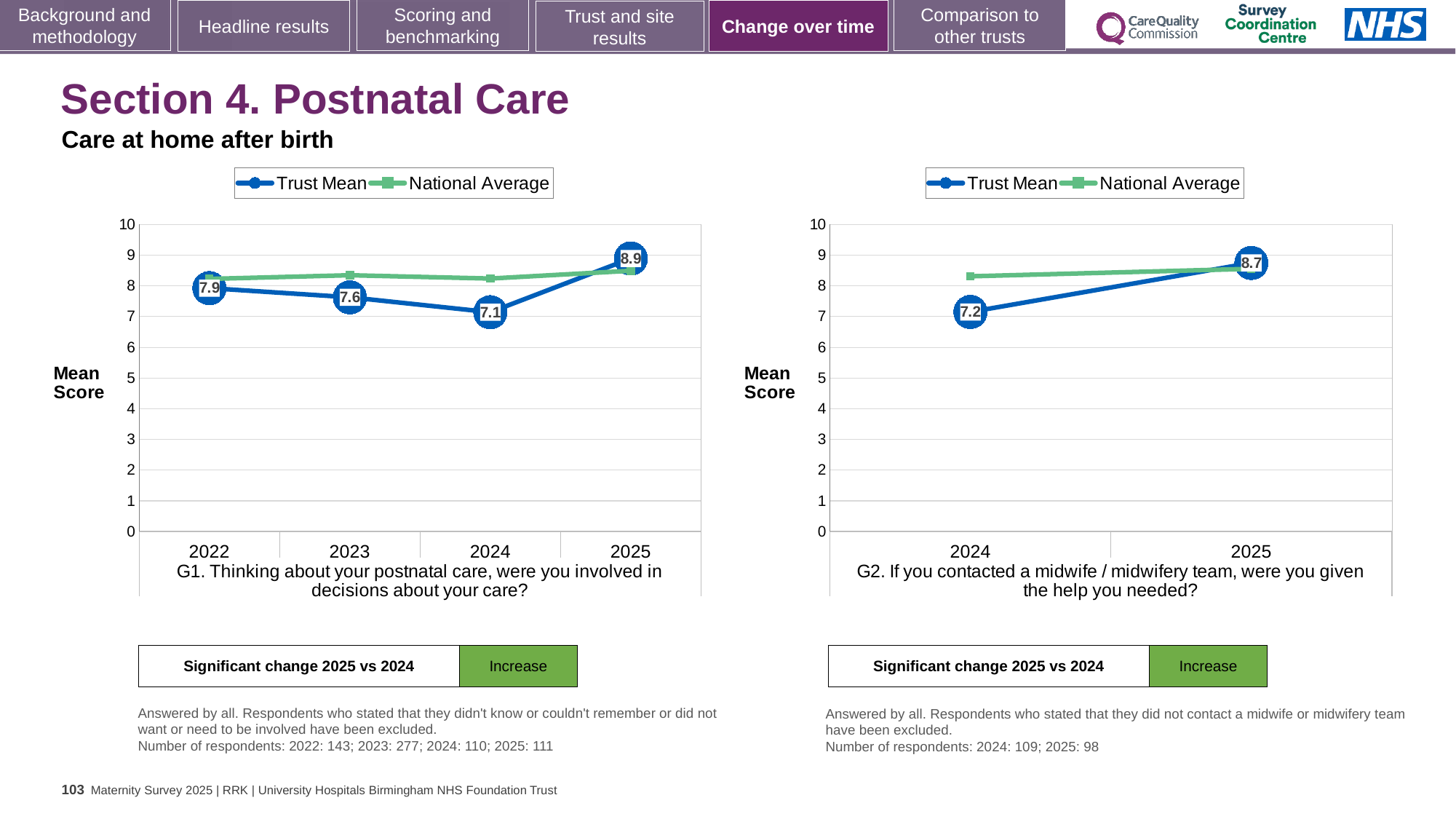
In the G2 chart (right), does the Trust Mean rise or fall from 2024 to 2025? Rise In the G1 chart (left), which year has the lowest Trust Mean score? 2024 How many years are shown on the x axis of the G1 chart (left)? 4 In the G2 chart (right), what is the difference between the Trust Mean scores for 2025 and 2024? 1.5 In the G1 chart (left), is the Trust Mean score higher in 2022 or in 2023? 2022 In the G1 chart (left), what is the Trust Mean score for 2025? 8.9 In the G2 chart (right), what is the Trust Mean score for 2024? 7.2 How many series does the legend of the G2 chart (right) list? 2 In the G1 chart (left), which year has the highest Trust Mean score? 2025 In the G1 chart (left), is the National Average for 2024 greater or less than 8? greater What kind of chart is the G2 chart (right)? Line chart In the G1 chart (left), what is the Trust Mean score for 2024? 7.1